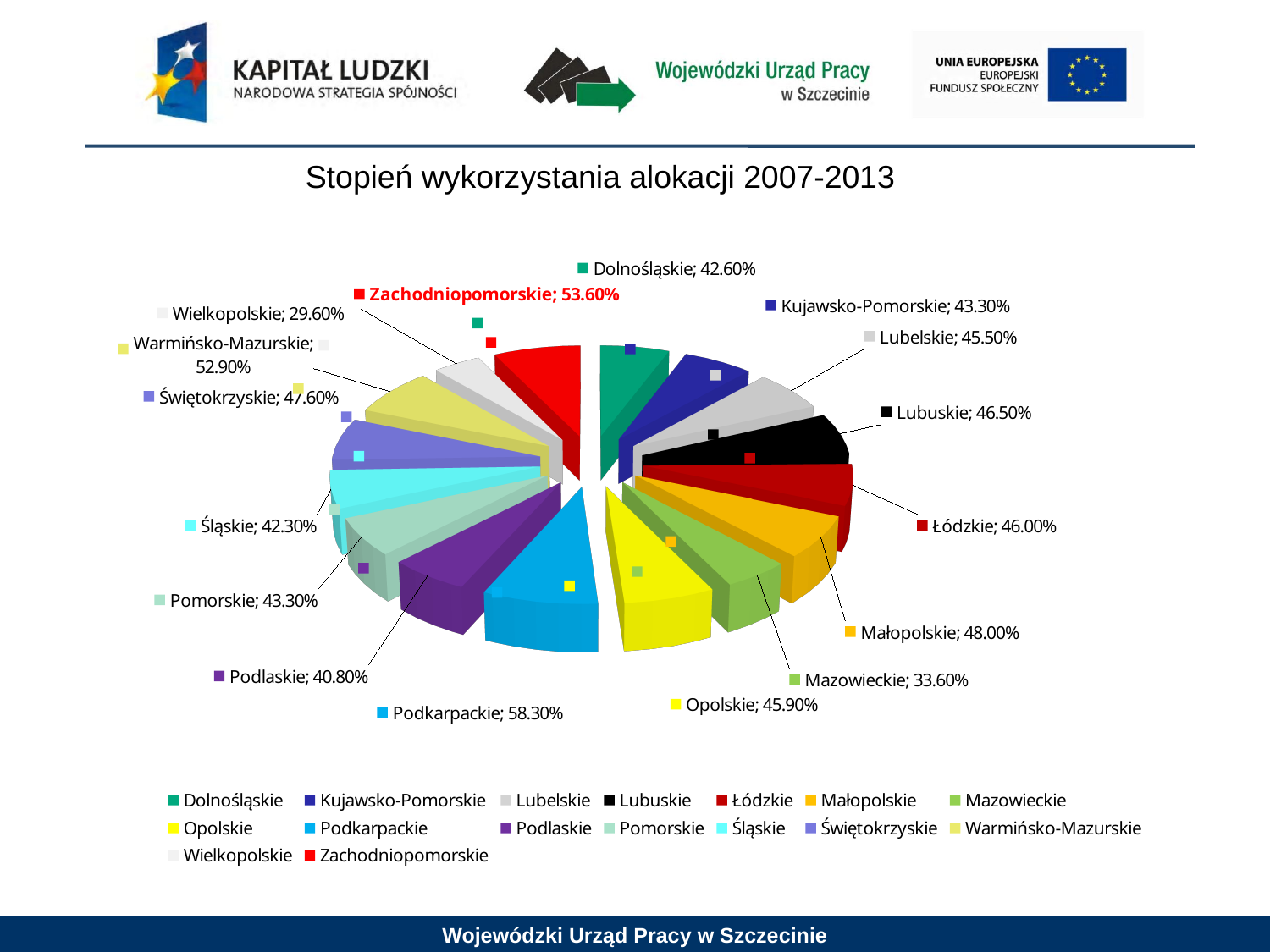
What is the difference between the values for Podkarpackie and Wielkopolskie? 28.70 percentage points Which region has the lowest value in the chart? Wielkopolskie What is the value shown for Mazowieckie? 33.60% What is the title of the chart? Stopień wykorzystania alokacji 2007-2013 What is the value shown for Podkarpackie? 58.30% Which region has the highest value in the chart? Podkarpackie What is the value shown for Zachodniopomorskie? 53.60% How many regions (slices) are shown in the chart? 16 What is the difference between the values for Zachodniopomorskie and Warmińsko-Mazurskie? 0.70 percentage points Which has a larger value, Małopolskie or Mazowieckie? Małopolskie What kind of chart is shown on the slide? pie chart What is the value shown for Warmińsko-Mazurskie? 52.90%